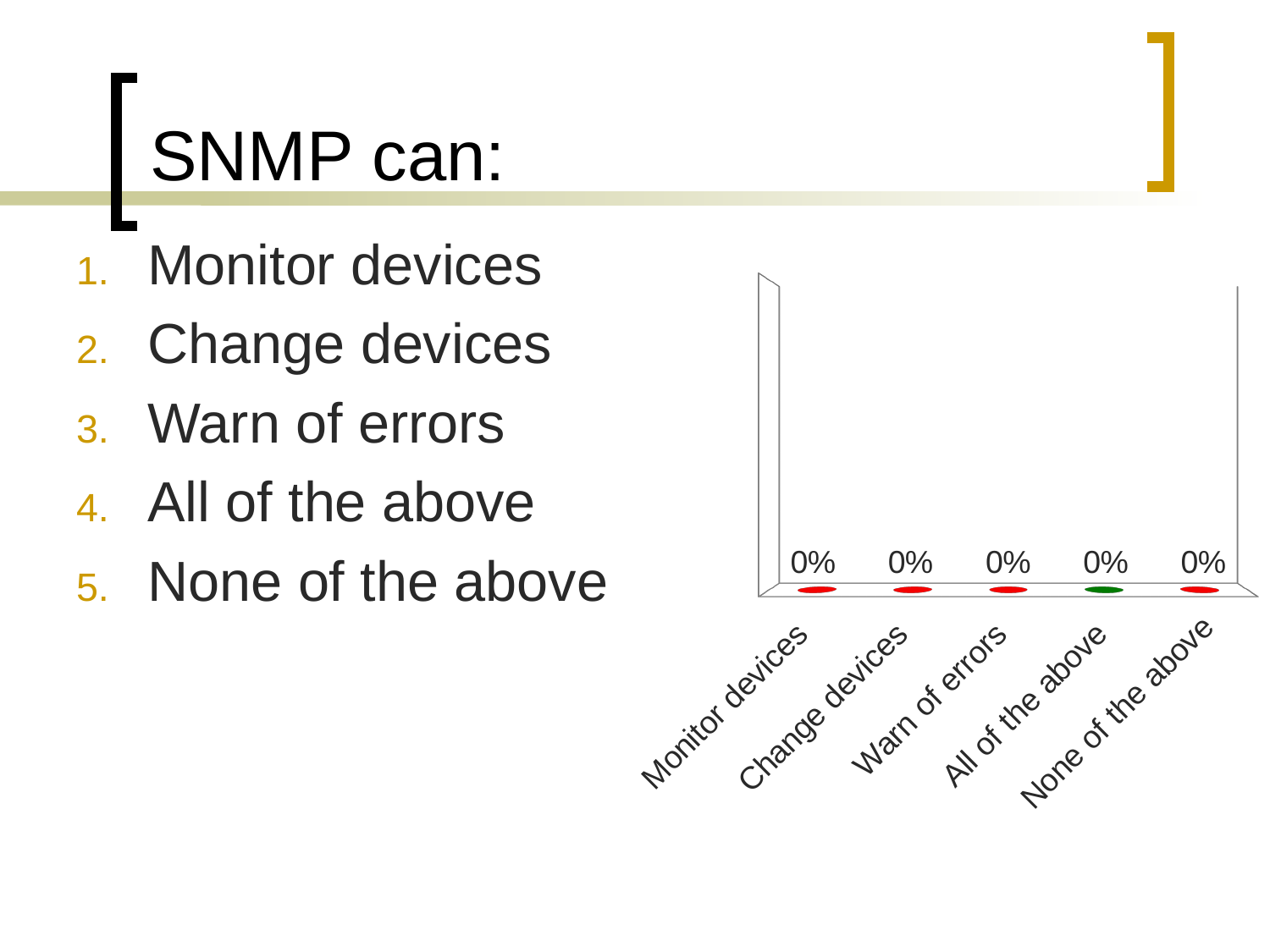
What is the value shown for None of the above? 0% What is the total of all five values shown on the chart? 0% How many categories are plotted on the chart? 5 What is the value shown for Warn of errors? 0% What is the value shown for Monitor devices? 0% What is the value shown for Change devices? 0% Which category's marker is coloured green rather than red? All of the above What is the value shown for All of the above? 0% What kind of chart is shown on the slide? bar chart What is the difference between the values for Monitor devices and All of the above? 0% What is the label of the first category on the x axis? Monitor devices